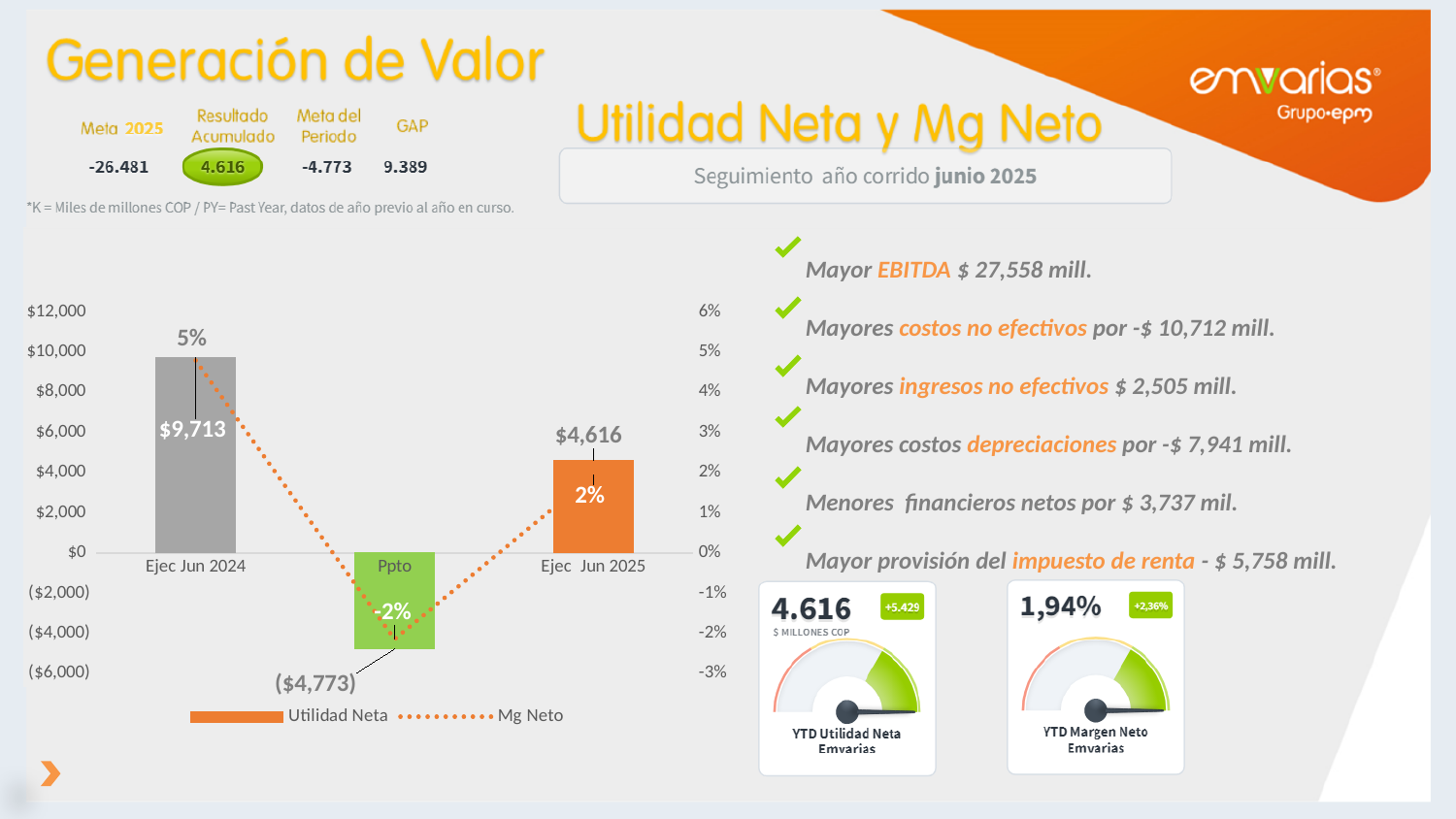
Which is larger, the Mg Neto for Ejec Jun 2024 or for Ejec Jun 2025? Ejec Jun 2024 Which category has the highest Utilidad Neta? Ejec Jun 2024 What is the Mg Neto value for Ppto? -2% What is the difference between the Utilidad Neta for Ejec Jun 2024 and Ejec Jun 2025? $5,097 What is the Mg Neto value for Ejec Jun 2024? 5% What is the Utilidad Neta value for Ejec Jun 2024? $9,713 What is the Utilidad Neta value for Ejec Jun 2025? $4,616 Which series is shown as a dotted line in the chart? Mg Neto Which category has the lowest Utilidad Neta? Ppto How many categories are shown on the x axis of the chart? 3 How many series does the chart legend list? 2 What is the Utilidad Neta value for Ppto? ($4,773)